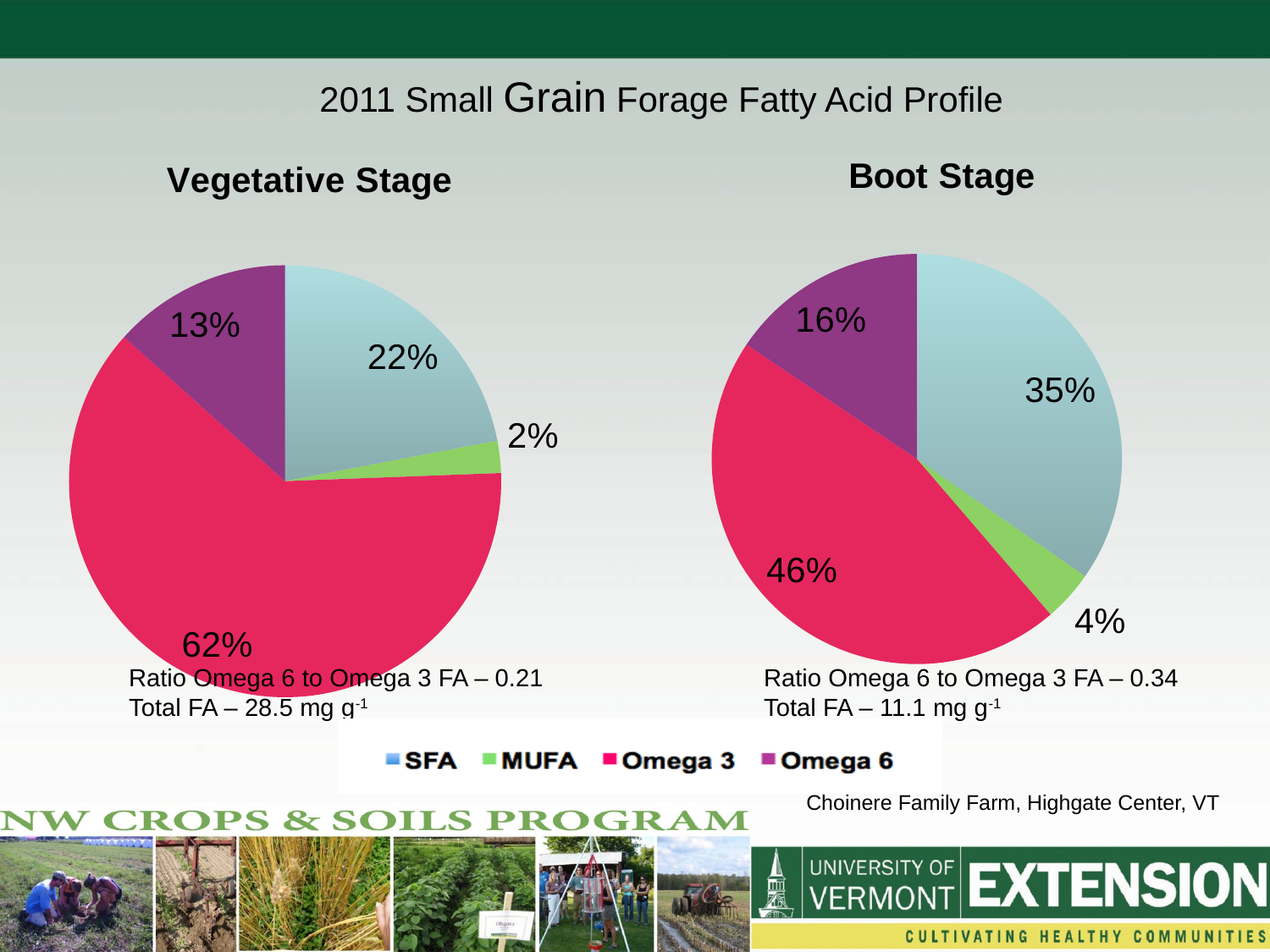
What kind of charts are shown on the slide? Pie charts In the Boot Stage pie chart, what share does Omega 6 have? 16% In the Boot Stage pie chart, which category has the largest slice? Omega 3 In the Vegetative Stage pie chart, which category has the smallest slice? MUFA How many entries does the legend list? 4 How many categories does each pie chart have? 4 In the Vegetative Stage pie chart, what share does MUFA have? 2% In the Boot Stage pie chart, what share does SFA have? 35% In the Vegetative Stage pie chart, what share does Omega 3 have? 62% What is the difference between the Omega 3 share in the Vegetative Stage chart and the Omega 3 share in the Boot Stage chart? 16% Which is larger: the SFA share in the Vegetative Stage chart or the SFA share in the Boot Stage chart? Boot Stage Which colour represents Omega 6 in the pie charts? Purple